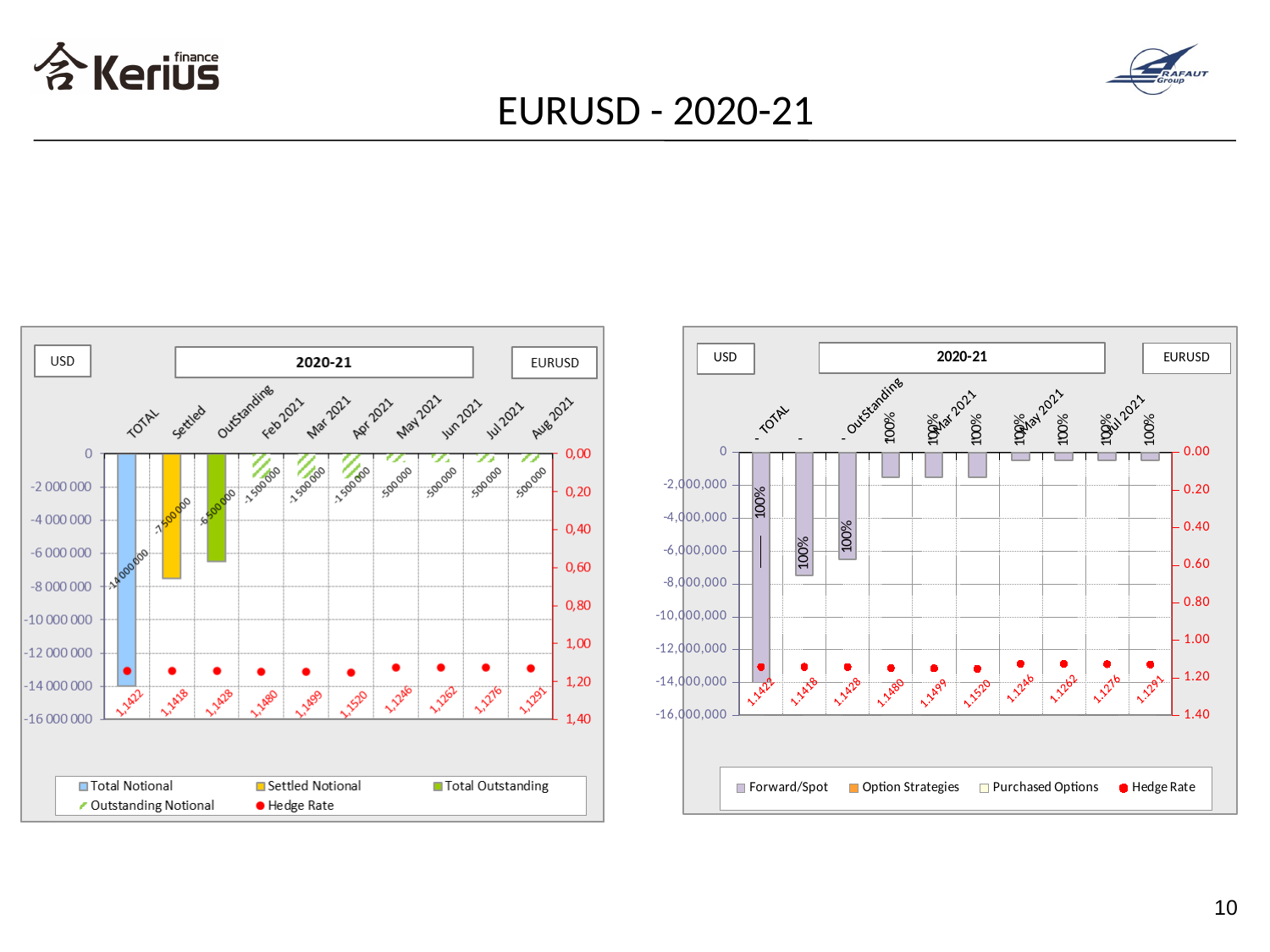
On the left chart, what is the difference between the Outstanding Notional for Feb 2021 and for Jun 2021? 1 000 000 On the right chart, what percentage label is shown on the Forward/Spot bar for TOTAL? 100% On the left chart, what is the Hedge Rate for May 2021? 1,1246 On the left chart, what is the Outstanding Notional value for Mar 2021? -1 500 000 On the left chart, how many series does the legend list? 5 On the left chart, what is the Total Notional value for TOTAL? -14 000 000 On the right chart, what is the Hedge Rate for Aug 2021? 1.1291 On the left chart, which month has the highest Hedge Rate? Apr 2021 On the left chart, what is the Hedge Rate for Apr 2021? 1,1520 On the left chart, what is the Total Outstanding value for OutStanding? -6 500 000 On the right chart, how many series does the legend list? 4 On the left chart, what is the Settled Notional value for Settled? -7 500 000